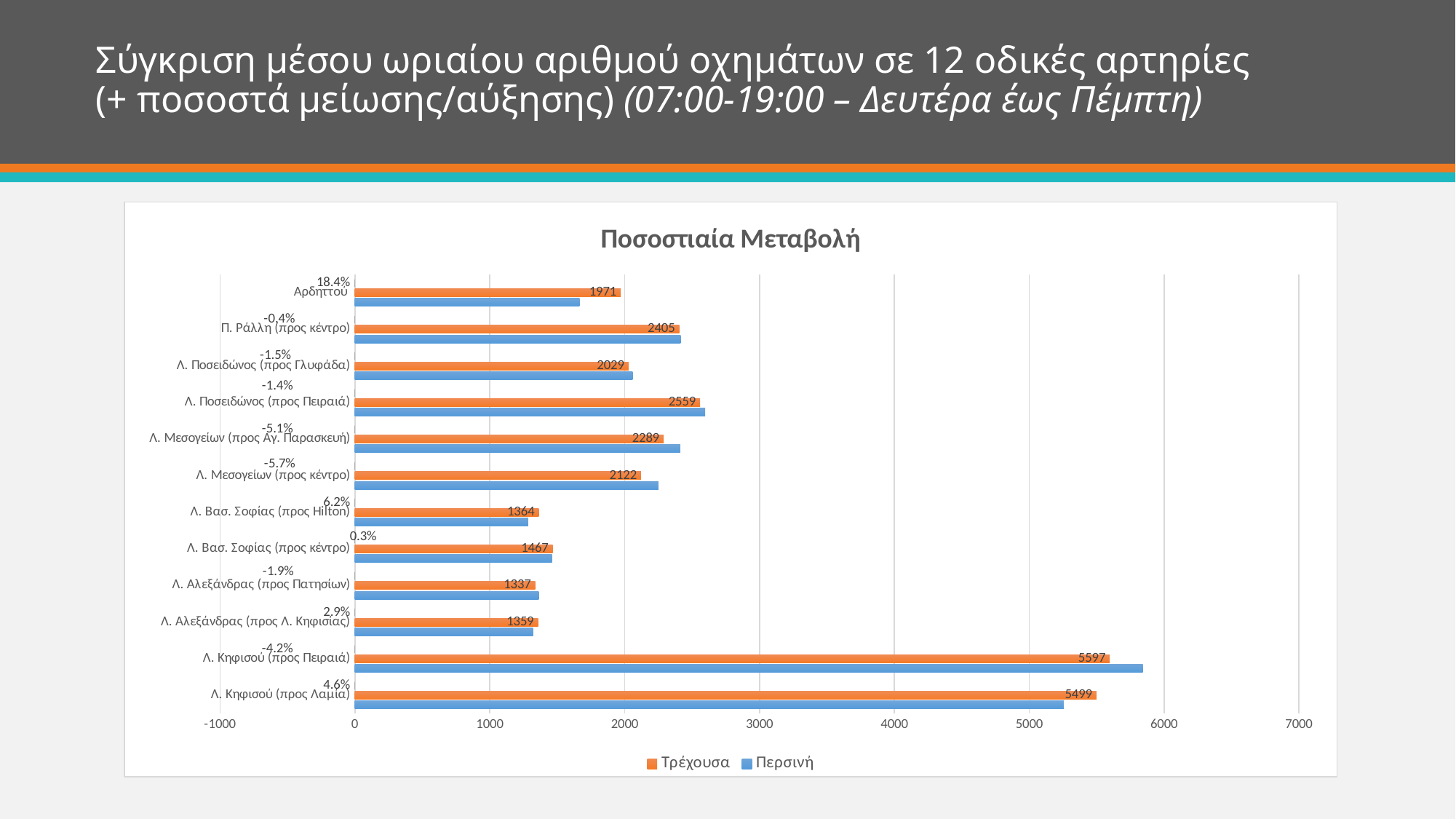
How many series does the legend list? 2 What is the difference between the Τρέχουσα values for Λ. Κηφισού (προς Πειραιά) and Λ. Κηφισού (προς Λαμία)? 98 How many categories (road arteries) are shown in the chart? 12 What is the difference between the Τρέχουσα values for Λ. Ποσειδώνος (προς Πειραιά) and Λ. Ποσειδώνος (προς Γλυφάδα)? 530 Which category has the lowest Τρέχουσα value? Λ. Αλεξάνδρας (προς Πατησίων) Which has the larger Τρέχουσα value, Π. Ράλλη (προς κέντρο) or Λ. Μεσογείων (προς Αγ. Παρασκευή)? Π. Ράλλη (προς κέντρο) Is the Περσινή value for Λ. Κηφισού (προς Πειραιά) greater or less than 5000? greater What is the Τρέχουσα value for Αρδηττού? 1971 Which category has the highest Τρέχουσα value? Λ. Κηφισού (προς Πειραιά) Is the Περσινή value for Αρδηττού greater or less than 2000? less What is the Τρέχουσα value for Λ. Μεσογείων (προς κέντρο)? 2122 What is the Τρέχουσα value for Λ. Κηφισού (προς Πειραιά)? 5597